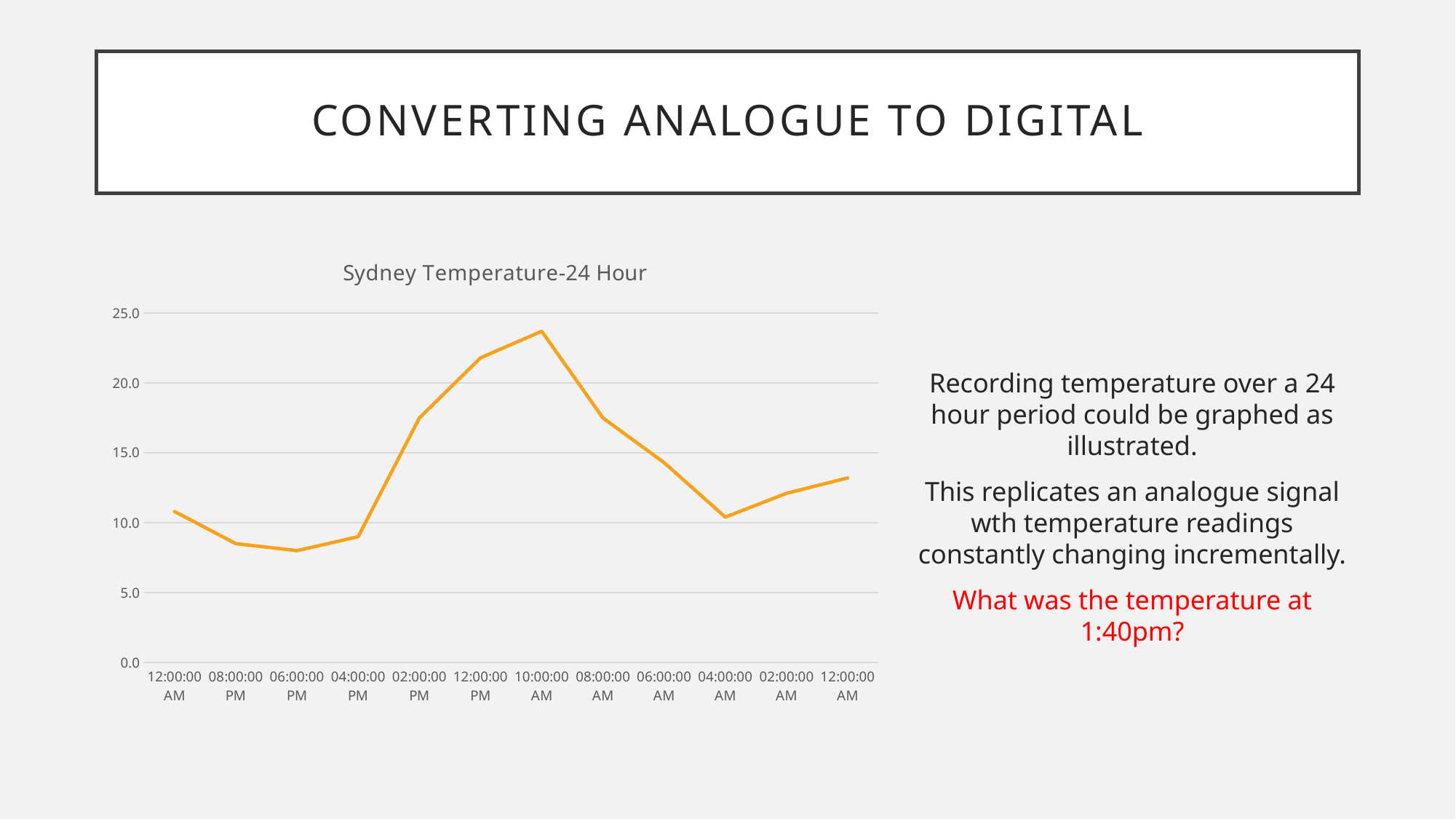
Is the value at 12:00:00 PM greater or less than 20.0? greater Is the value at 08:00:00 AM greater or less than 15.0? greater Is the value at 10:00:00 AM greater or less than 20.0? greater Does the line rise or fall between 04:00:00 PM and 10:00:00 AM along the x axis? rise What is the title of the chart? Sydney Temperature-24 Hour How many data points are plotted on the line? 12 At which time on the x axis does the temperature reach its highest value? 10:00:00 AM What kind of chart is shown on the slide? line chart Which has the higher temperature, 02:00:00 PM or 08:00:00 PM? 02:00:00 PM Which has the higher temperature, 10:00:00 AM or 04:00:00 PM? 10:00:00 AM